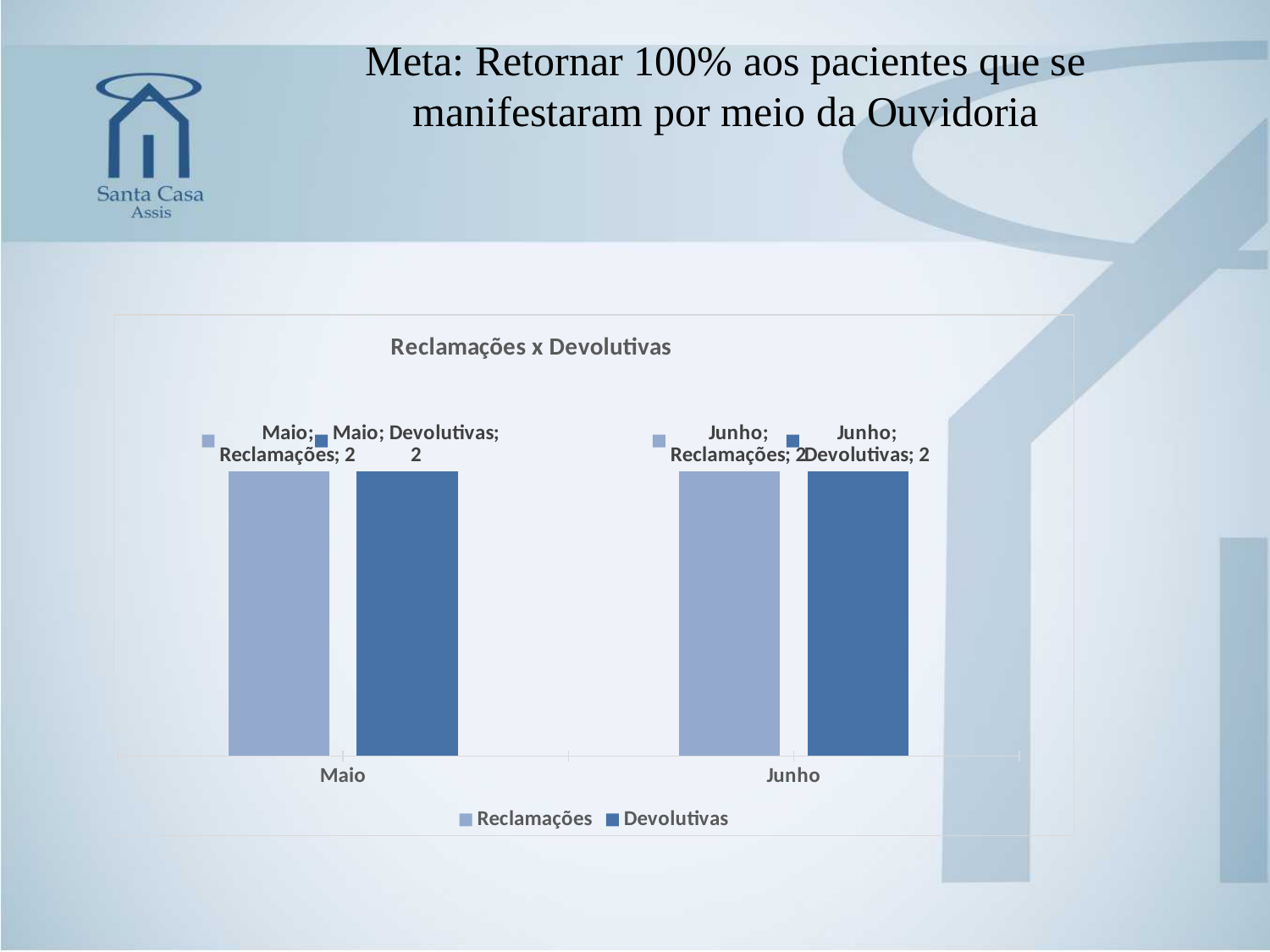
What is the title of the chart? Reclamações x Devolutivas How many series does the legend list? 2 What is the value for Reclamações in Junho? 2 Do the Devolutivas values rise, fall or stay the same from Maio to Junho? Stay the same What kind of chart is shown on the slide? Bar chart What is the value for Reclamações in Maio? 2 Which series is shown in the darker blue colour in the chart? Devolutivas How many categories are shown on the x axis of the chart? 2 What is the difference between the Reclamações value in Maio and the Reclamações value in Junho? 0 What is the difference between Reclamações and Devolutivas in Maio? 0 What is the value for Devolutivas in Maio? 2 What is the value for Devolutivas in Junho? 2